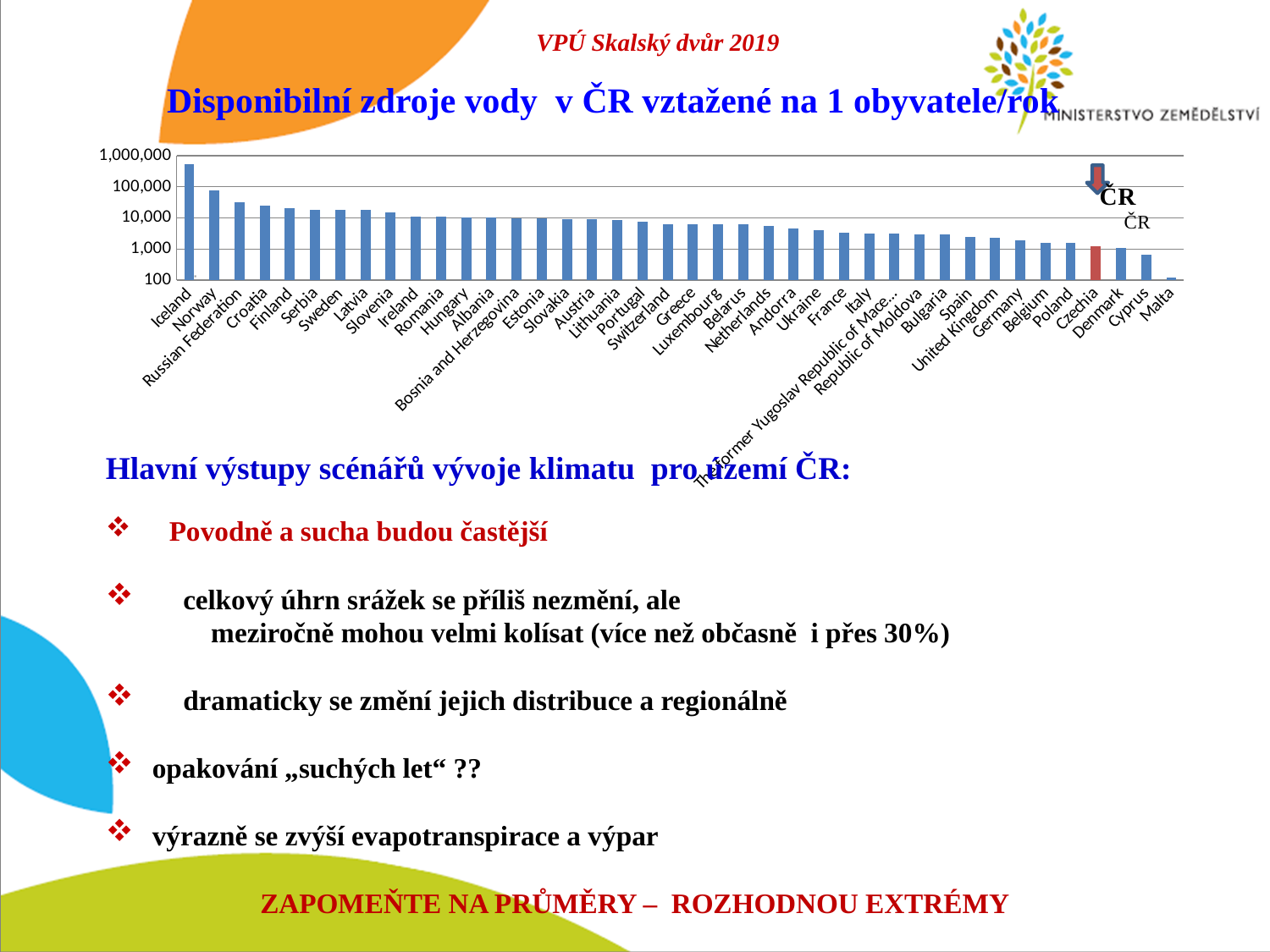
How many countries are shown in the chart? 40 Which country has the lowest value in the chart? Malta Do the values rise or fall moving from left to right along the x axis? fall Which has the larger value, Iceland or Norway? Iceland Is the value for Croatia greater or less than 10,000? greater Is the value for Cyprus greater or less than 1,000? less Is the value for Iceland greater or less than 100,000? greater What kind of chart is shown on the slide? bar chart Which country's bar is highlighted in red in the chart? Czechia Which country has the highest value in the chart? Iceland